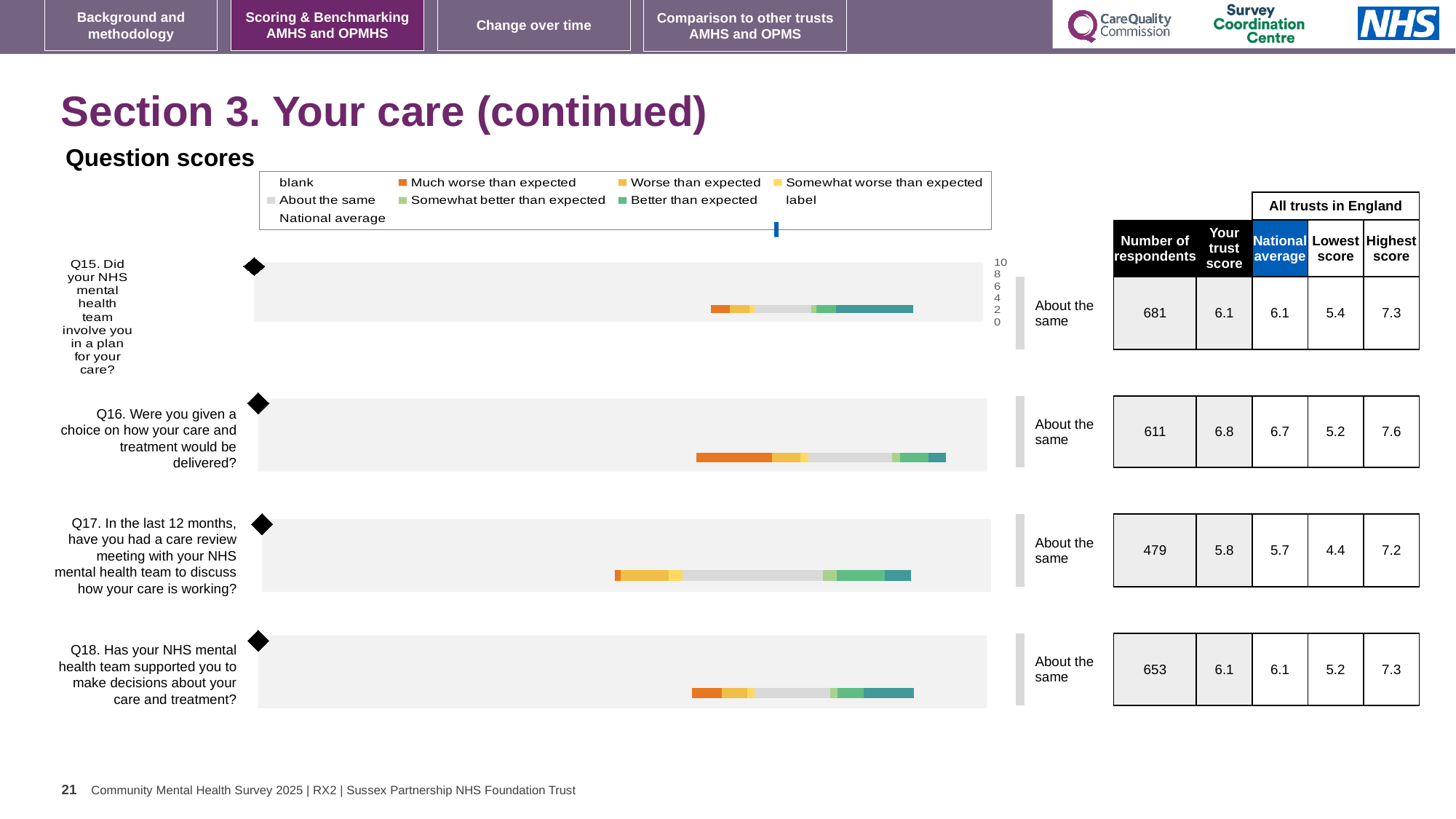
Which question has the lowest trust score? Q17 What is the highest score across all trusts in England for Q18? 7.3 What is the difference between the highest score and the lowest score for Q16? 2.4 What is the trust score for Q16 (choice on how care and treatment would be delivered)? 6.8 How many questions (Q15 to Q18) have a score bar on the slide? 4 Which legend entry is shown with an orange marker? Much worse than expected What benchmark label is shown next to the Q17 bar? About the same What kind of chart is used to show the question scores for Q15 to Q18? bar chart What is the lowest score across all trusts in England for Q17? 4.4 What is the number of respondents for Q15? 681 Which question has the highest number of respondents? Q15 For Q16, which is larger: the trust score or the national average? the trust score